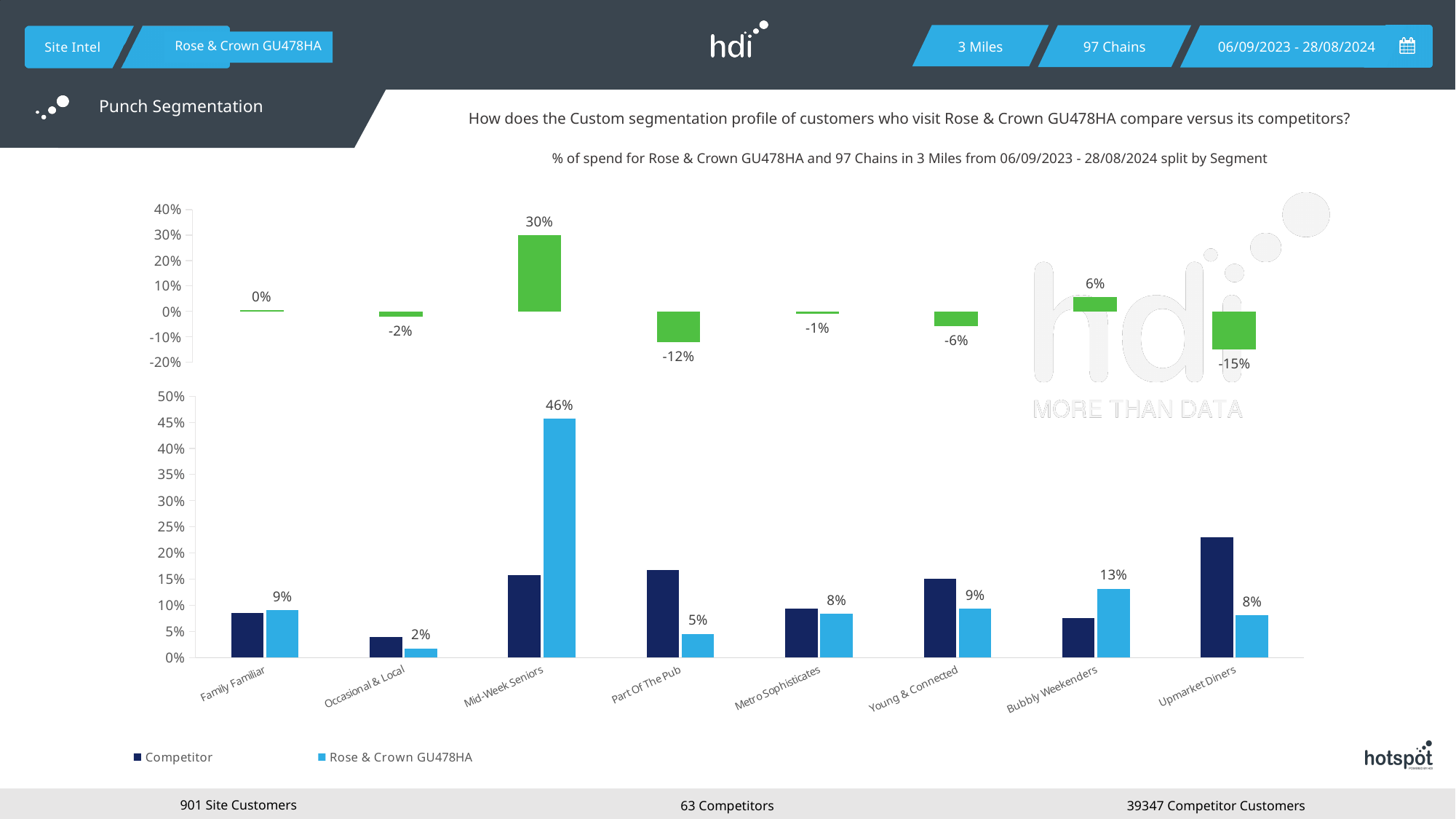
In the bottom chart, is the Competitor value for Upmarket Diners greater or less than 20%? greater In the top chart, which segment has the lowest value? Upmarket Diners How many segments are shown on the x axis of the bottom chart? 8 In the top chart, which segment has the highest value? Mid-Week Seniors How many series does the legend of the bottom chart list? 2 In the bottom chart, what is the difference between the Rose & Crown GU478HA values for Mid-Week Seniors and Bubbly Weekenders? 33% In the bottom chart, which is larger for Part Of The Pub: the Competitor bar or the Rose & Crown GU478HA bar? Competitor In the bottom chart, what is the value for Rose & Crown GU478HA in the Bubbly Weekenders segment? 13% In the top chart, what is the value shown for Part Of The Pub? -12% In the top chart, what is the value shown for Upmarket Diners? -15% In the bottom chart, which segment has the lowest Rose & Crown GU478HA value? Occasional & Local In the bottom chart, what is the value for Rose & Crown GU478HA in the Mid-Week Seniors segment? 46%